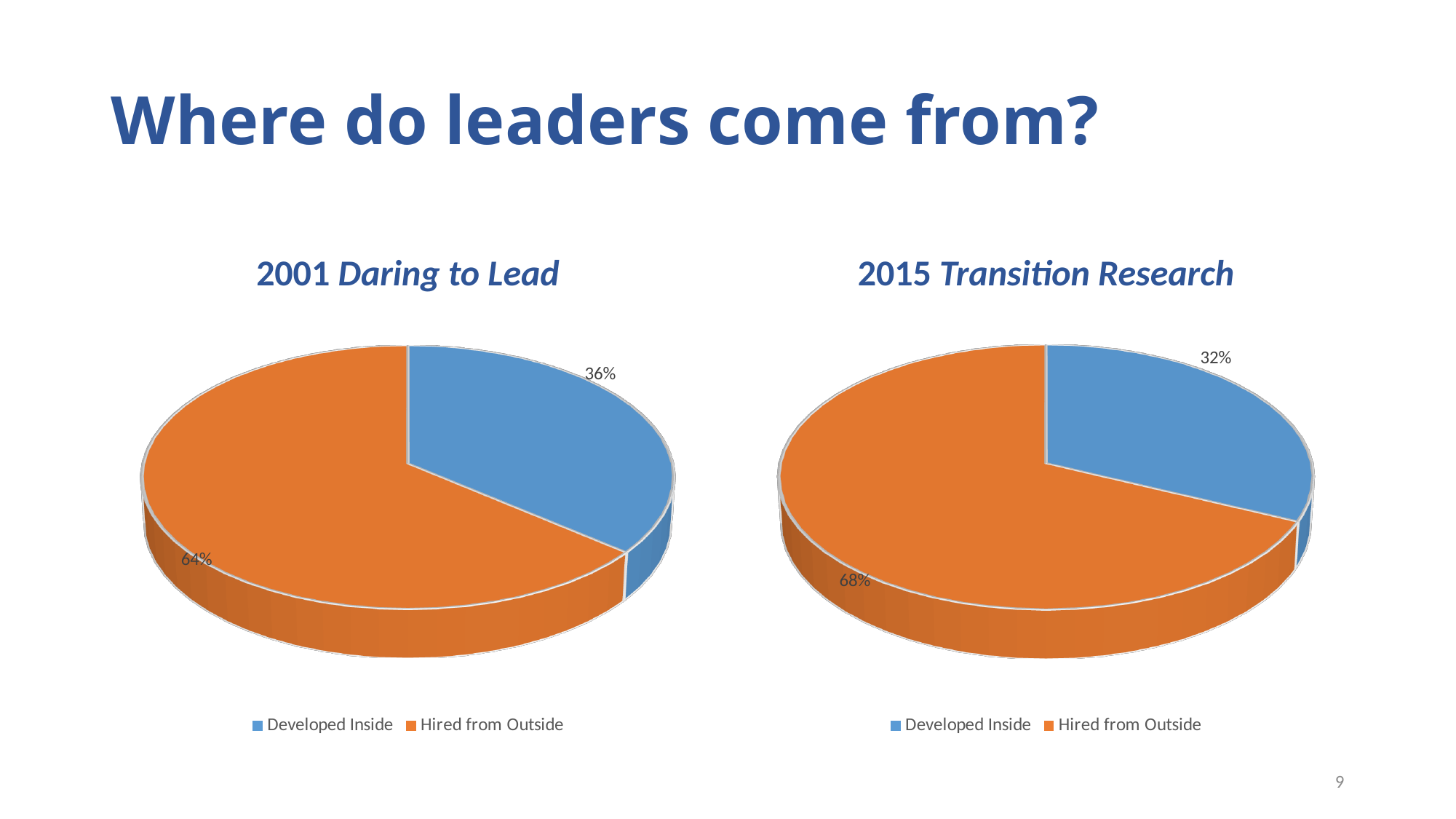
In the 2015 Transition Research chart, which category has the smallest slice? Developed Inside How many categories does the legend of the 2015 Transition Research chart list? 2 What type of chart is used on this slide? Pie chart In the 2015 Transition Research chart, what is the difference between the Hired from Outside and Developed Inside shares? 36% In the 2001 Daring to Lead chart, which category has the largest slice? Hired from Outside In the 2015 Transition Research chart, what share of leaders were Developed Inside? 32% In the 2001 Daring to Lead chart, which colour represents Hired from Outside? Orange Which chart shows a larger Developed Inside share, 2001 Daring to Lead or 2015 Transition Research? 2001 Daring to Lead In the 2001 Daring to Lead chart, what share of leaders were Hired from Outside? 64% In the 2015 Transition Research chart, what share of leaders were Hired from Outside? 68% In the 2001 Daring to Lead chart, what is the difference between the Hired from Outside and Developed Inside shares? 28% In the 2001 Daring to Lead chart, what share of leaders were Developed Inside? 36%